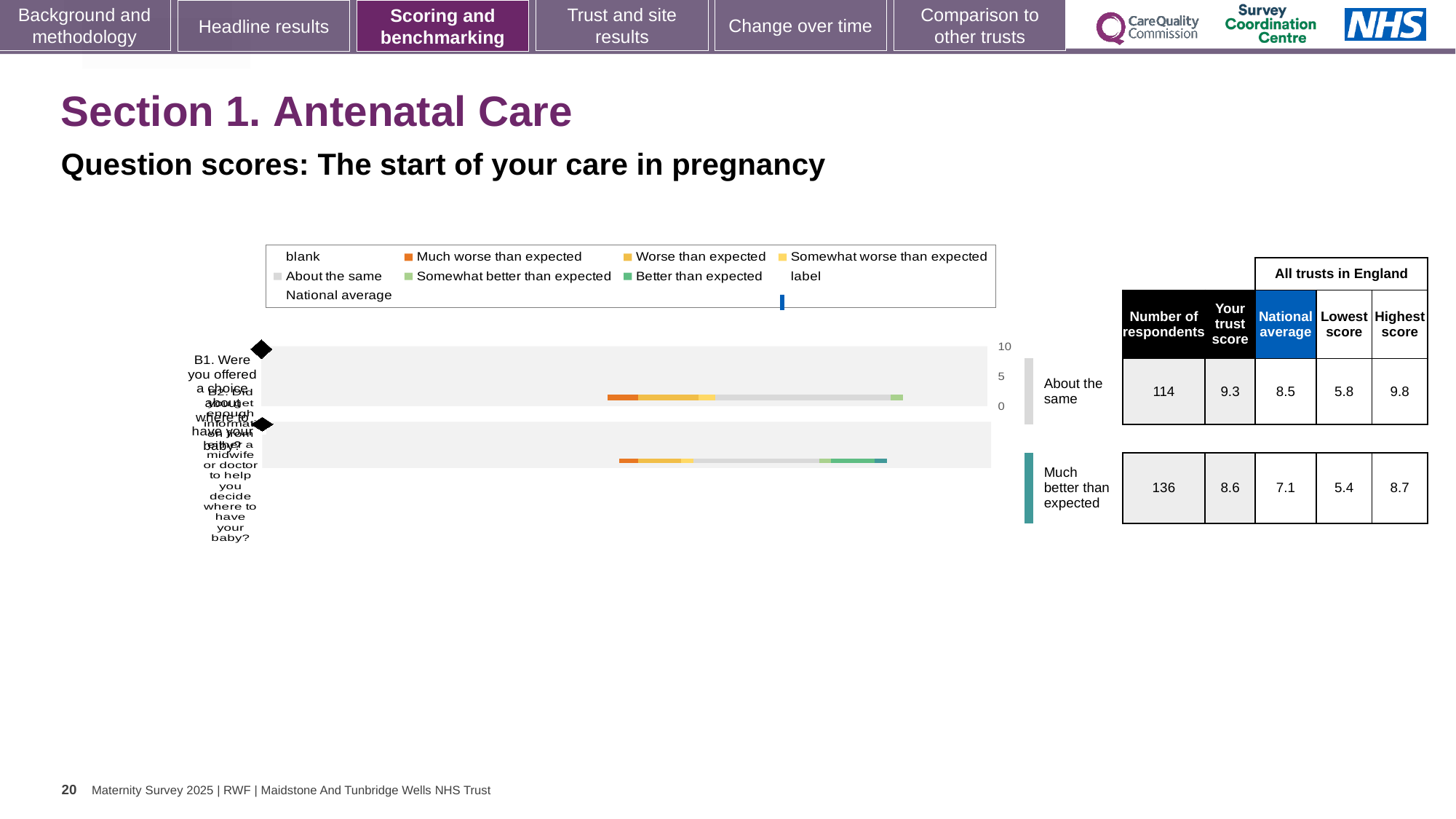
What is the national average score for question B1? 8.5 What is the lowest score among all trusts in England for question B1? 5.8 What benchmark category is shown for question B2? Much better than expected What kind of chart is shown on the slide? bar chart By how much does the trust score for question B2 exceed the national average for B2? 1.5 How many questions (bars) are plotted in the chart? 2 What is the subtitle describing the chart's question scores? Question scores: The start of your care in pregnancy Which question has the higher trust score, B1 or B2? B1 What is the difference between the highest and lowest scores for question B1? 4.0 What is the trust score for question B1 (Were you offered a choice about where to have your baby?)? 9.3 What is the highest score among all trusts in England for question B2? 8.7 How many respondents answered question B2 (Did you get enough information from a midwife or doctor to help you decide where to have your baby?)? 136